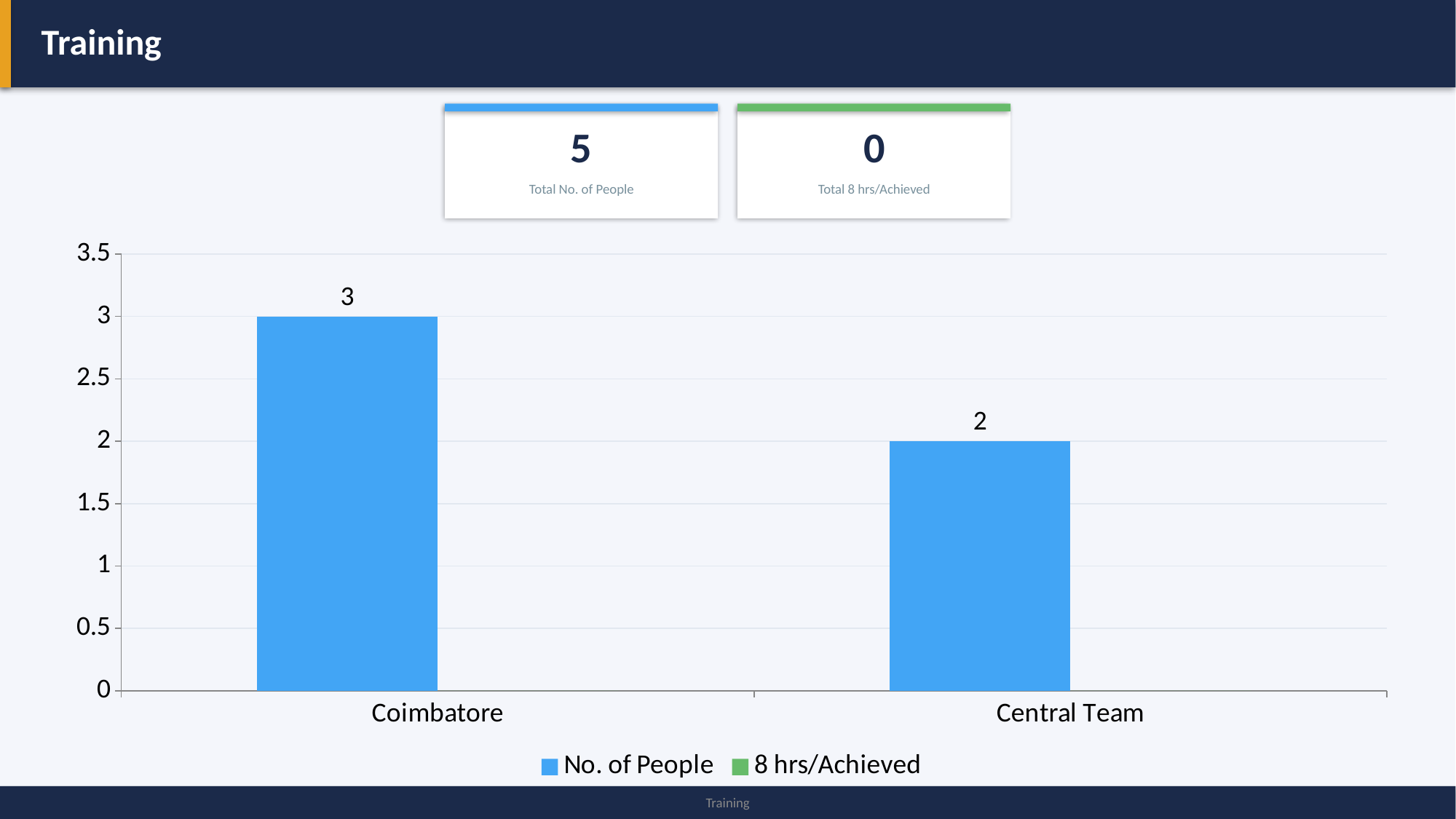
What colour are the No. of People bars? blue Which has more No. of People, Coimbatore or Central Team? Coimbatore Which category has the lowest No. of People? Central Team What kind of chart is shown on the slide? bar chart Which category has the highest No. of People? Coimbatore Do the No. of People values rise or fall from Coimbatore to Central Team? fall Is the value for No. of People for Coimbatore greater or less than 2.5? greater What is the value for No. of People for Coimbatore? 3 How many series does the legend list? 2 What is the value for No. of People for Central Team? 2 What is the difference in No. of People between Coimbatore and Central Team? 1 How many categories are shown on the x axis? 2